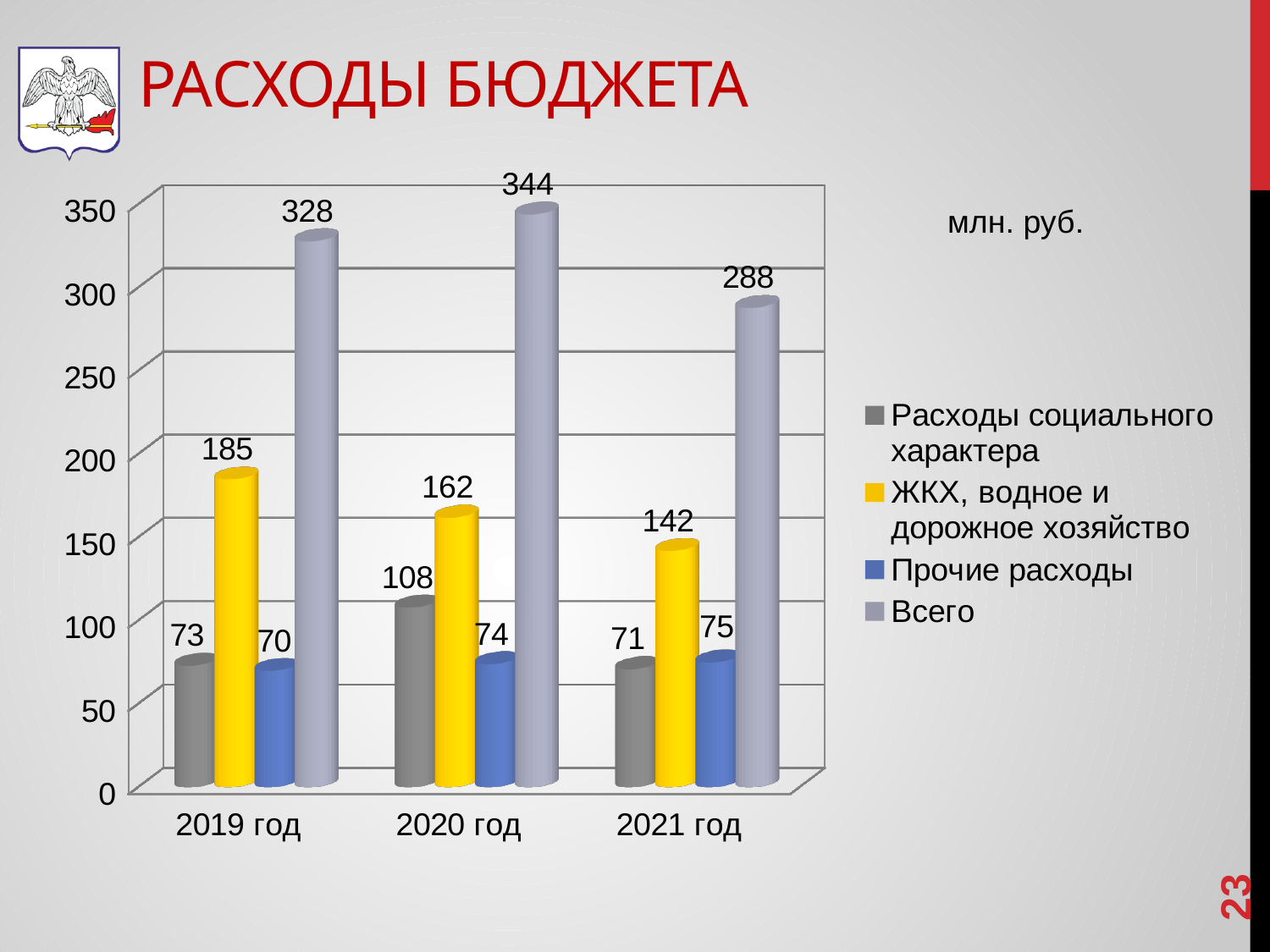
What is the value of "Расходы социального характера" for 2020 год? 108 What is the value of "Прочие расходы" for 2021 год? 75 How many series does the legend list? 4 Which is larger: "Расходы социального характера" in 2019 год or in 2020 год? 2020 год In which year is "Всего" the highest? 2020 год What is the difference between "Всего" in 2020 год and 2021 год? 56 How many years are shown on the x axis? 3 What is the value of "ЖКХ, водное и дорожное хозяйство" for 2019 год? 185 What kind of chart is shown on the slide? Bar chart What is the value of "Всего" for 2020 год? 344 In which year is "ЖКХ, водное и дорожное хозяйство" the lowest? 2021 год Does "ЖКХ, водное и дорожное хозяйство" rise or fall from 2019 год to 2021 год? Fall